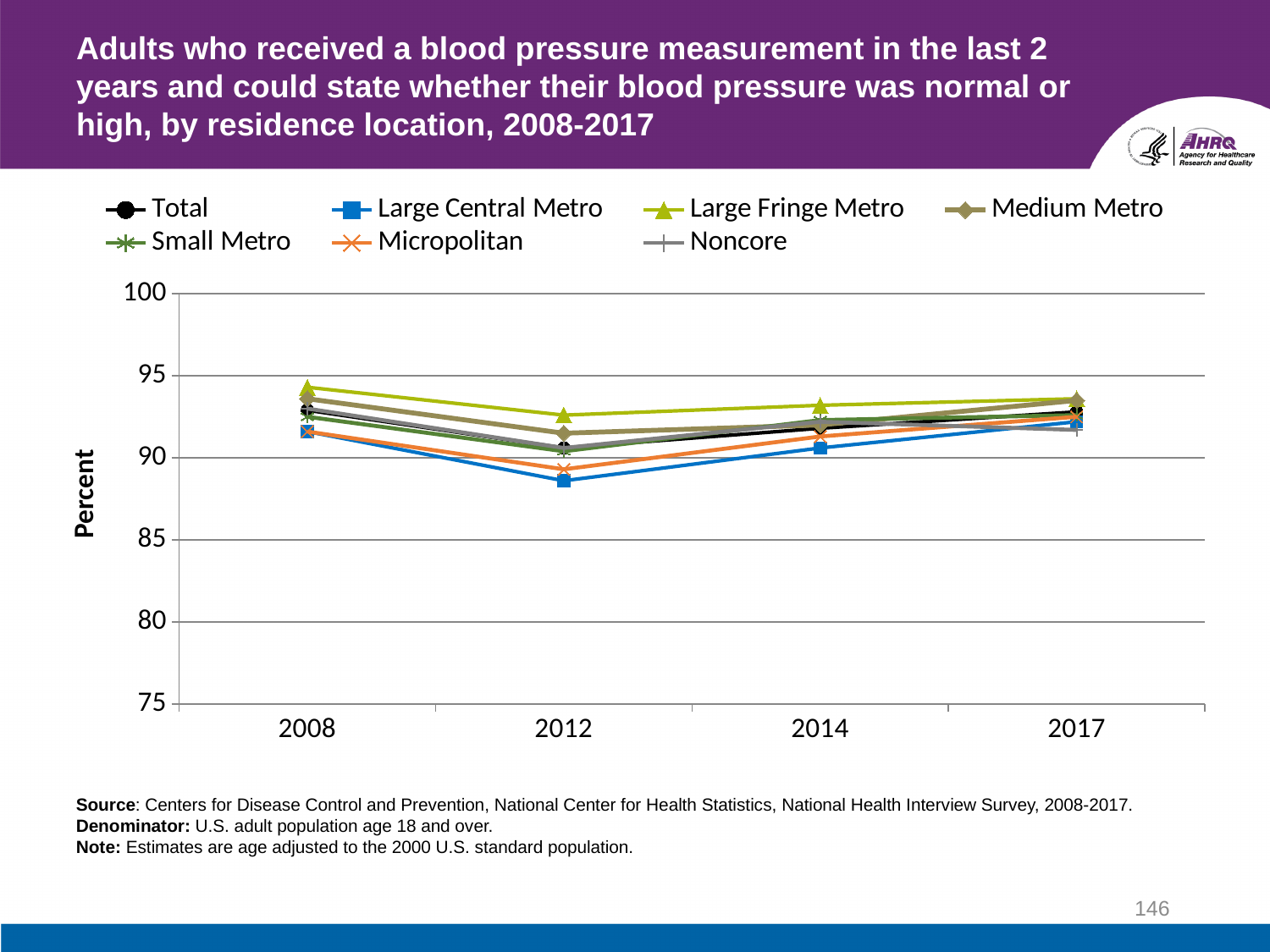
Is the value for Large Central Metro in 2012 greater or less than 90? less What is the label on the y axis? Percent Is the value for Large Fringe Metro in 2008 greater or less than 95? less Which residence location has the lowest value in 2012? Large Central Metro Which residence location has the highest value in 2008? Large Fringe Metro In 2014, which is larger: the value for Large Fringe Metro or the value for Large Central Metro? Large Fringe Metro Which residence location has the highest value in 2012? Large Fringe Metro Is the value for Total in 2008 greater or less than 90? greater What kind of chart is shown on the slide? line chart How many series does the legend list? 7 Does the value for Large Central Metro rise or fall from 2012 to 2017? rise How many years are plotted along the x axis? 4